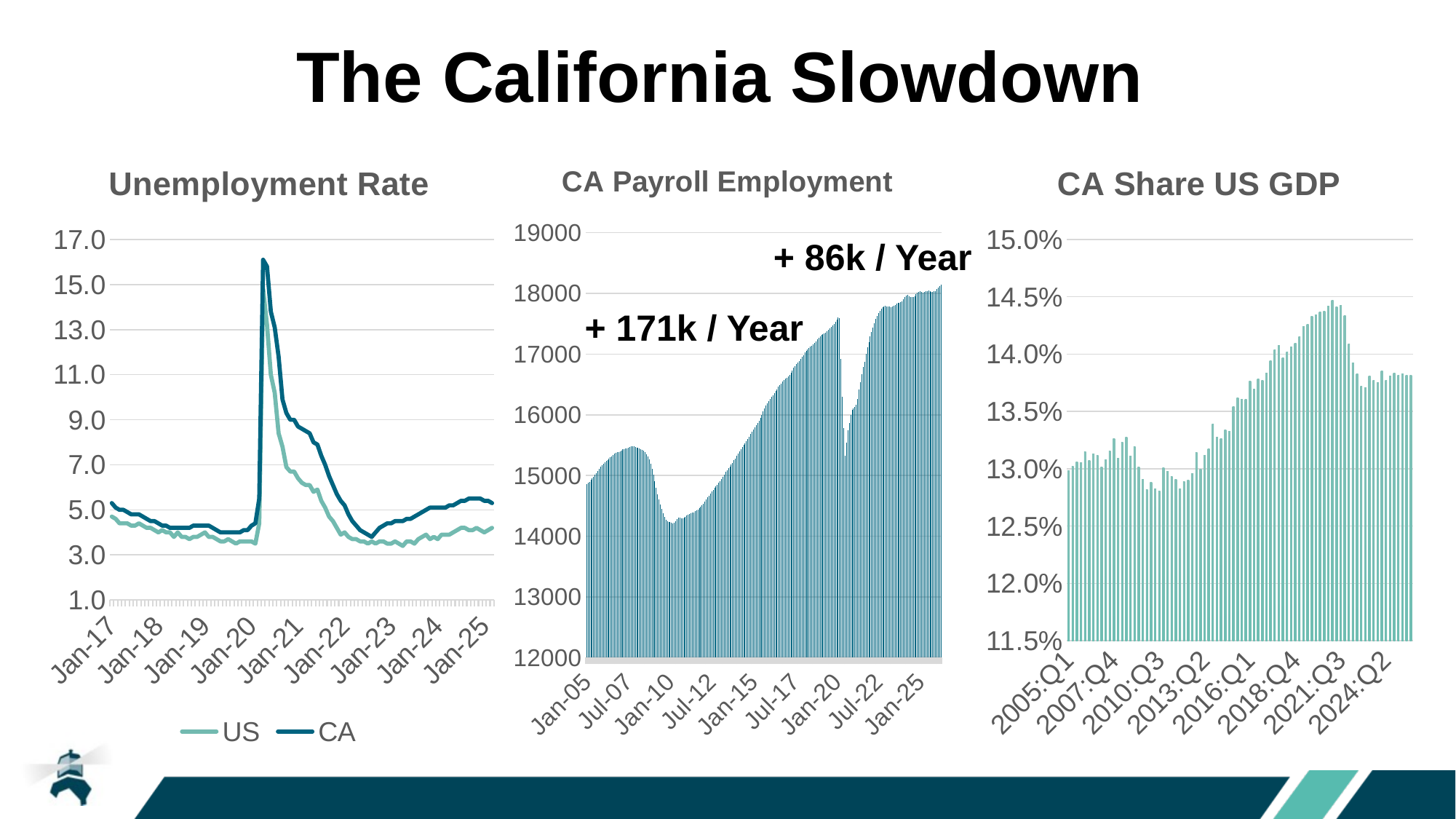
In the Unemployment Rate chart, which series reaches the higher peak around 2020? CA What kind of chart is the CA Payroll Employment chart? bar chart In the Unemployment Rate chart, how many series does the legend list? 2 How many charts are shown on the slide? 3 In the CA Share US GDP chart, is the value at 2024:Q2 greater or less than 14.0%? less In the CA Share US GDP chart, is the highest value greater or less than 14.0%? greater In the Unemployment Rate chart, is the peak value for CA greater or less than 15.0? greater In the Unemployment Rate chart, what are the two series named in the legend? US and CA In the Unemployment Rate chart, at Jan-25 which series is higher, US or CA? CA In the CA Payroll Employment chart, what annual growth rate is annotated for the earlier period? + 171k / Year